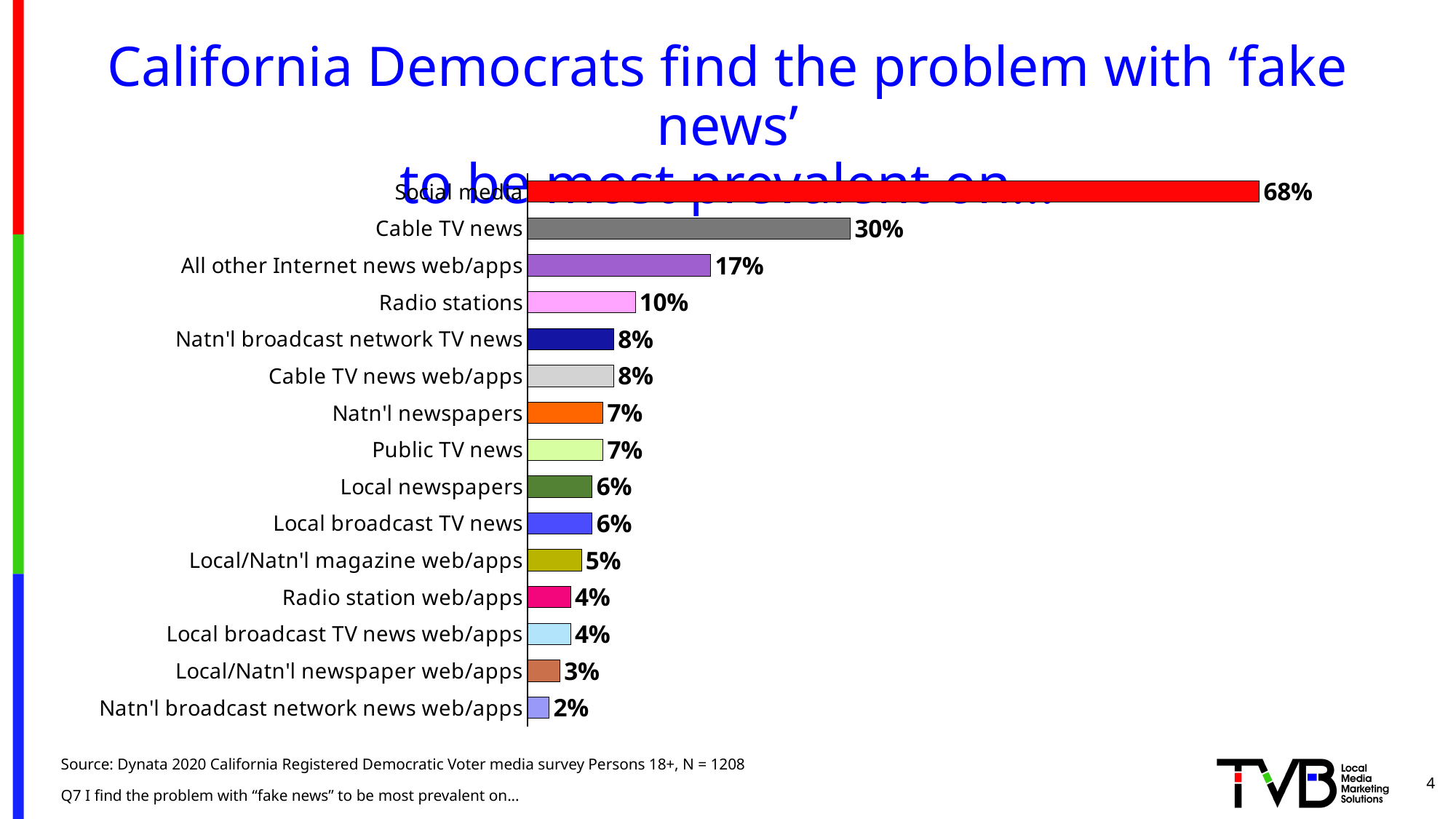
What percentage is shown for All other Internet news web/apps? 17% Which is larger, the value for Natn'l newspapers or the value for Local/Natn'l newspaper web/apps? Natn'l newspapers Which category has the lowest value? Natn'l broadcast network news web/apps What is the value for Local/Natn'l magazine web/apps? 5% Which category has the highest value? Social media What is the difference between the values for Radio stations and Local newspapers? 4% What colour is the bar for Social media? Red What kind of chart is shown on the slide? Bar chart What percentage is shown for Cable TV news? 30% How many categories are shown in the chart? 15 What is the difference between the values for Social media and Cable TV news? 38% What is the value for Radio stations? 10%